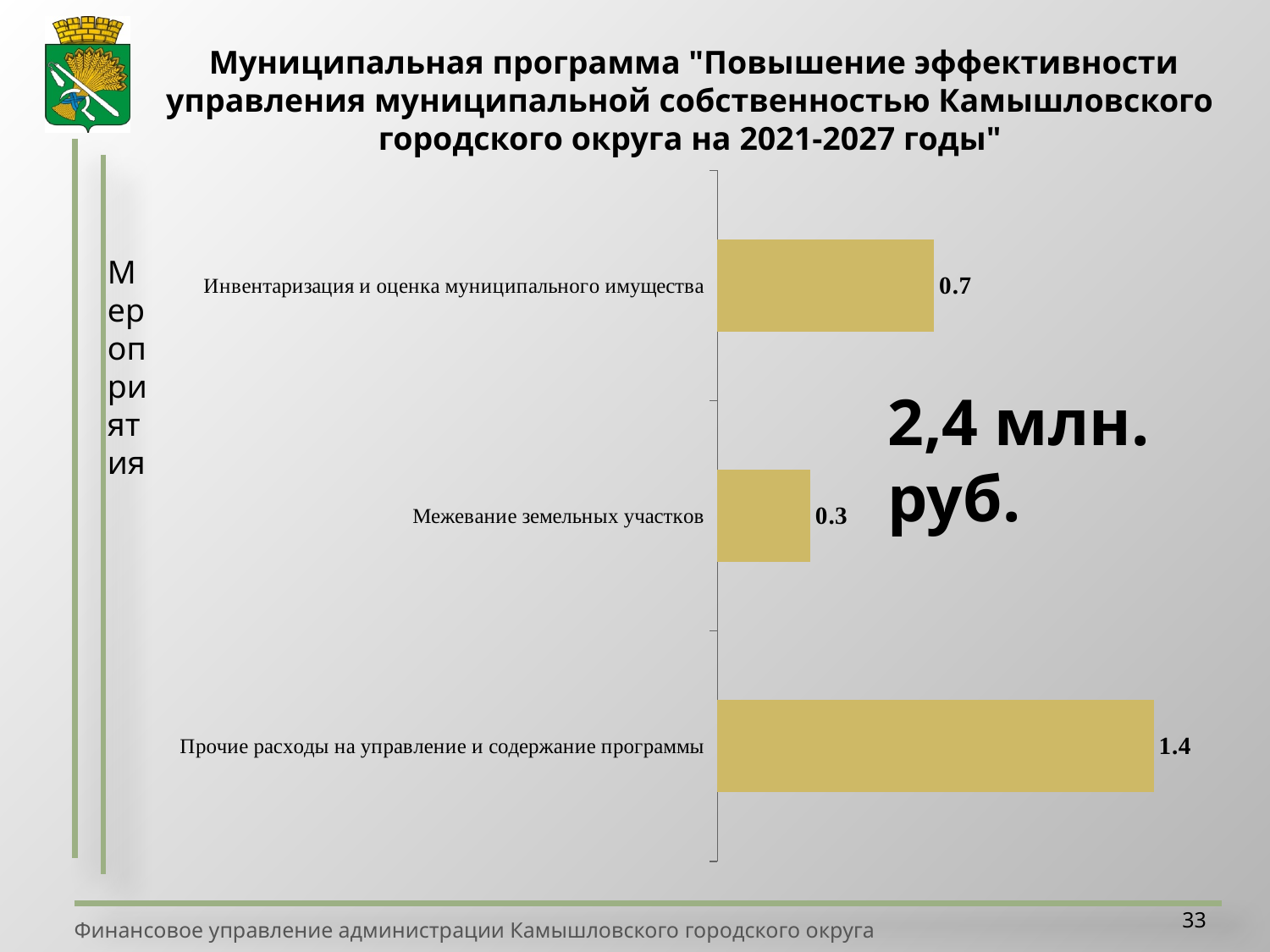
Which category has the lowest value? Межевание земельных участков Which is larger: the value for Инвентаризация и оценка муниципального имущества or the value for Межевание земельных участков? Инвентаризация и оценка муниципального имущества What is the value for Инвентаризация и оценка муниципального имущества? 0.7 What total amount is printed in large text next to the chart? 2,4 млн. руб. Which category has the highest value? Прочие расходы на управление и содержание программы What is the difference between the values for Инвентаризация и оценка муниципального имущества and Межевание земельных участков? 0.4 What is the value for Прочие расходы на управление и содержание программы? 1.4 What is the difference between the values for Прочие расходы на управление и содержание программы and Инвентаризация и оценка муниципального имущества? 0.7 What is the value for Межевание земельных участков? 0.3 What kind of chart is shown on the slide? Bar chart What colour are the bars in the chart? Gold (yellow) How many categories are shown in the chart? 3